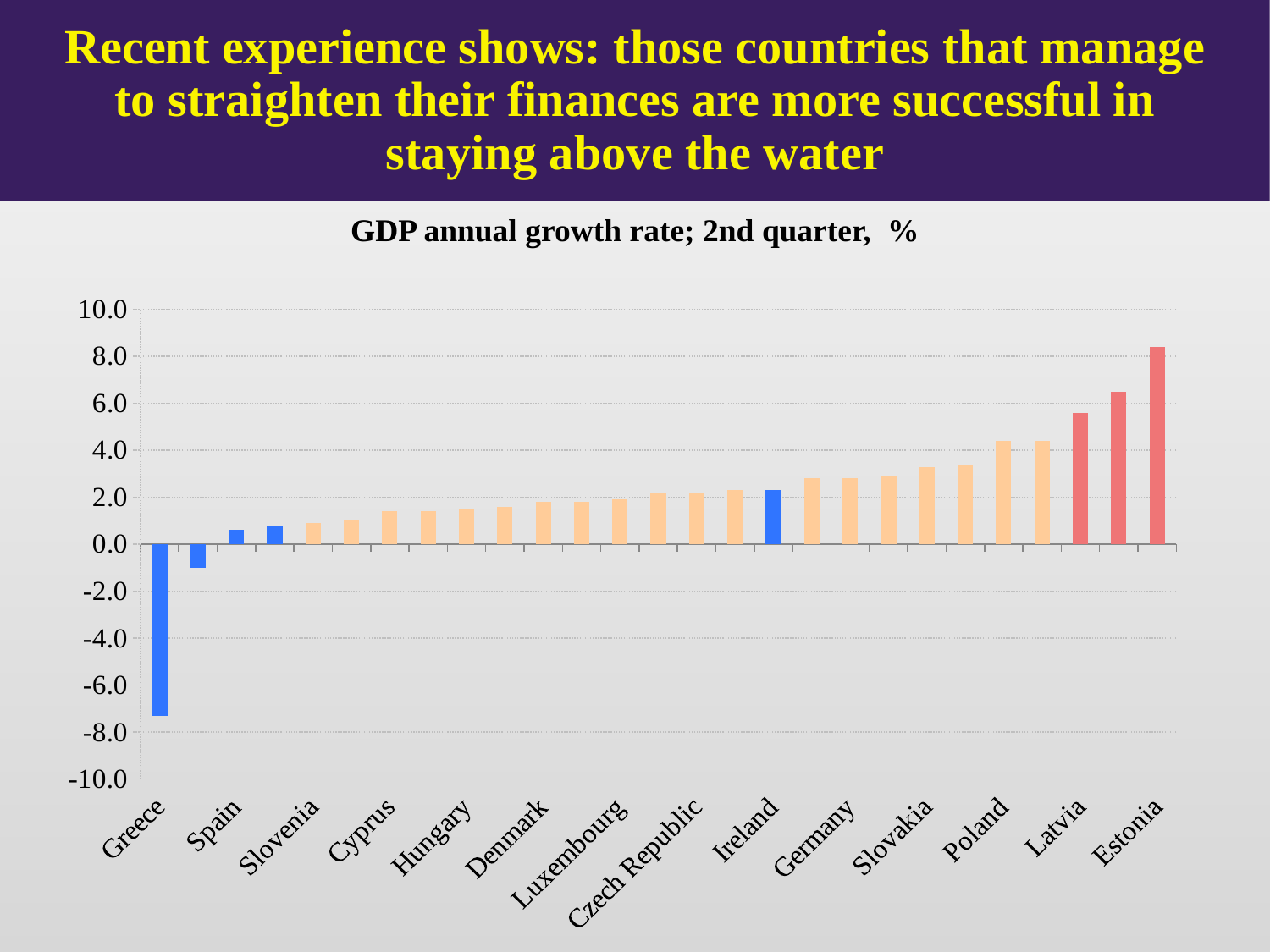
Is the value for Poland greater or less than 2.0? greater Is the value for Latvia greater or less than 4.0? greater What is the title of the chart? GDP annual growth rate; 2nd quarter, % What kind of chart is shown on the slide? bar chart Is the value for Estonia greater or less than 8.0? greater Which country has the highest GDP annual growth rate in the chart? Estonia What is the highest value shown on the y axis? 10.0 Which country has the lowest GDP annual growth rate in the chart? Greece Which is larger, the value for Greece or the value for Estonia? Estonia Do the values generally rise or fall moving from left to right along the x axis? rise